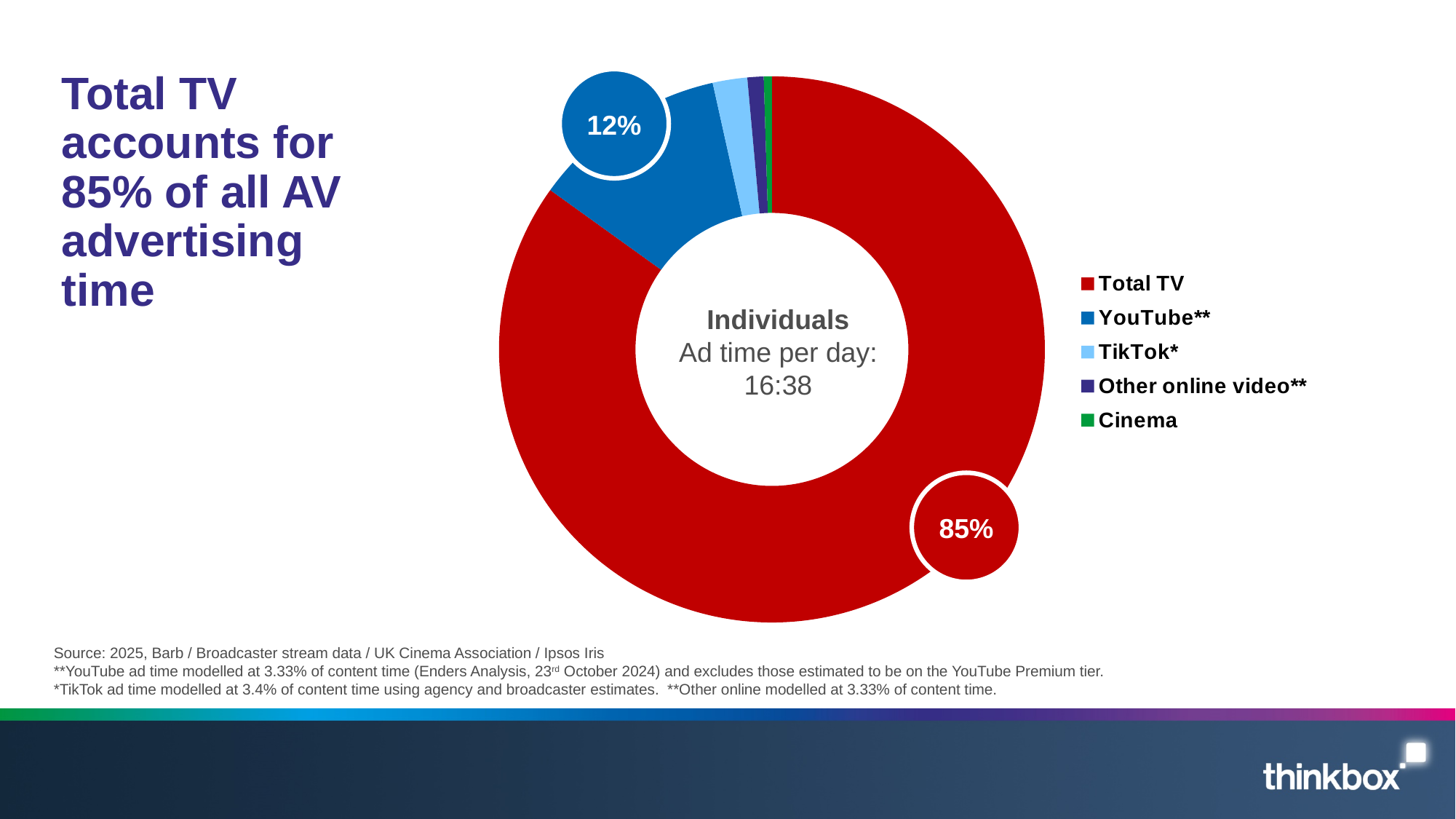
Which colour represents Total TV in the doughnut chart? Red What share of AV advertising time does Total TV account for in the doughnut chart? 85% What share of AV advertising time does YouTube** account for in the doughnut chart? 12% Which category is listed last in the legend of the doughnut chart? Cinema Which is larger in the doughnut chart, the Total TV slice or the YouTube** slice? Total TV Which category has the largest slice in the doughnut chart? Total TV Which audience is the doughnut chart about, according to the text in its centre? Individuals What is the difference in percentage points between the Total TV share and the YouTube** share? 73 percentage points What ad time per day is shown in the centre of the doughnut chart? 16:38 What kind of chart is shown on the slide? Doughnut (pie) chart Is the Total TV share in the doughnut chart greater or less than 50%? greater How many categories does the legend of the doughnut chart list? 5